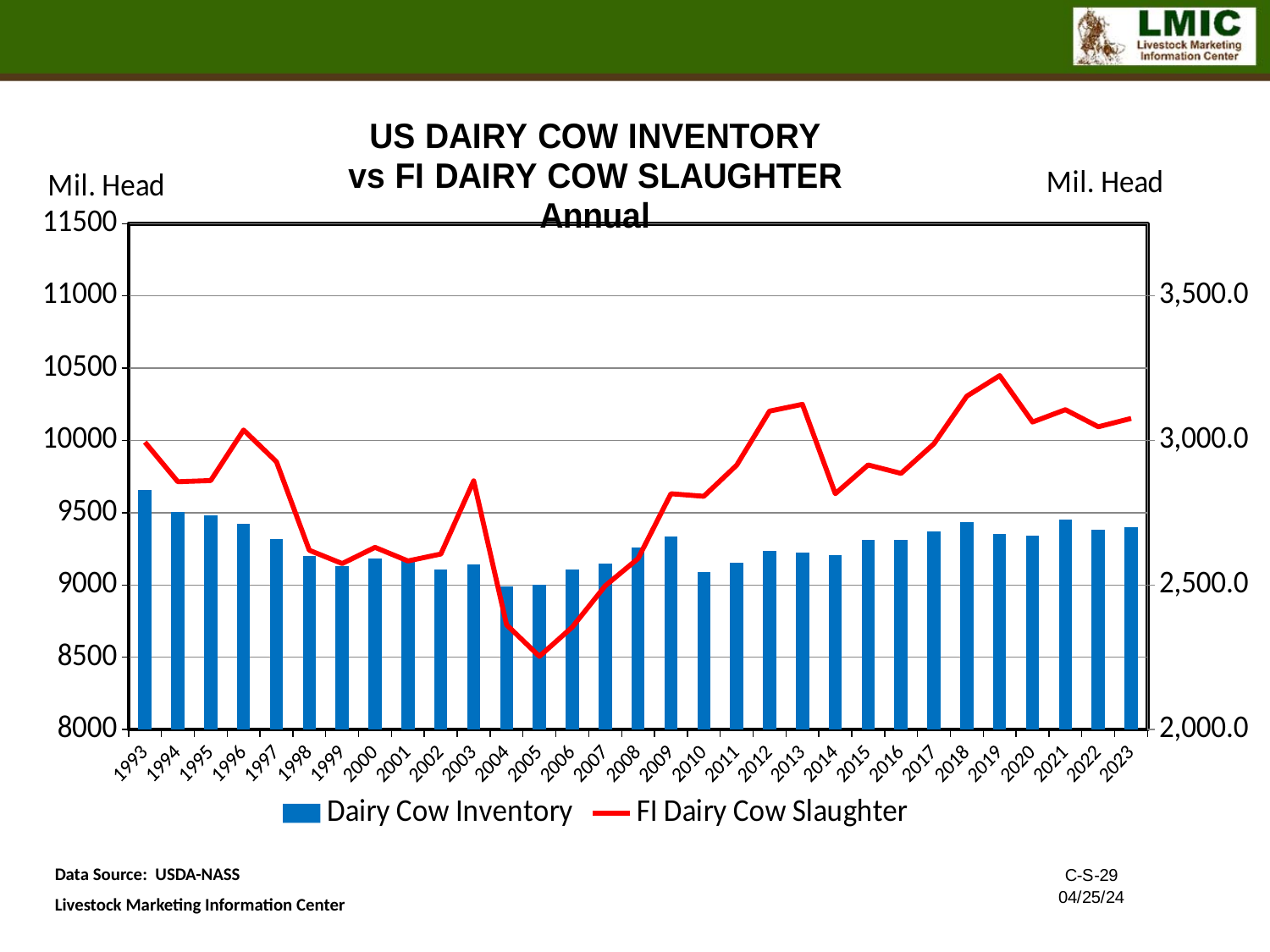
Is the FI Dairy Cow Slaughter for 2019 greater or less than 3,000.0? greater Which is larger, the Dairy Cow Inventory in 1993 or in 2023? 1993 What kind of chart is shown on the slide? A combination bar and line chart Which year has the highest Dairy Cow Inventory? 1993 Does the Dairy Cow Inventory rise or fall from 1993 to 1998? fall How many series does the legend list? 2 How many years are plotted along the x axis? 31 Is the Dairy Cow Inventory for 1993 greater or less than 9500? greater Is the FI Dairy Cow Slaughter for 2005 greater or less than 2,500.0? less Which year has the highest FI Dairy Cow Slaughter? 2019 Which year has the lowest FI Dairy Cow Slaughter? 2005